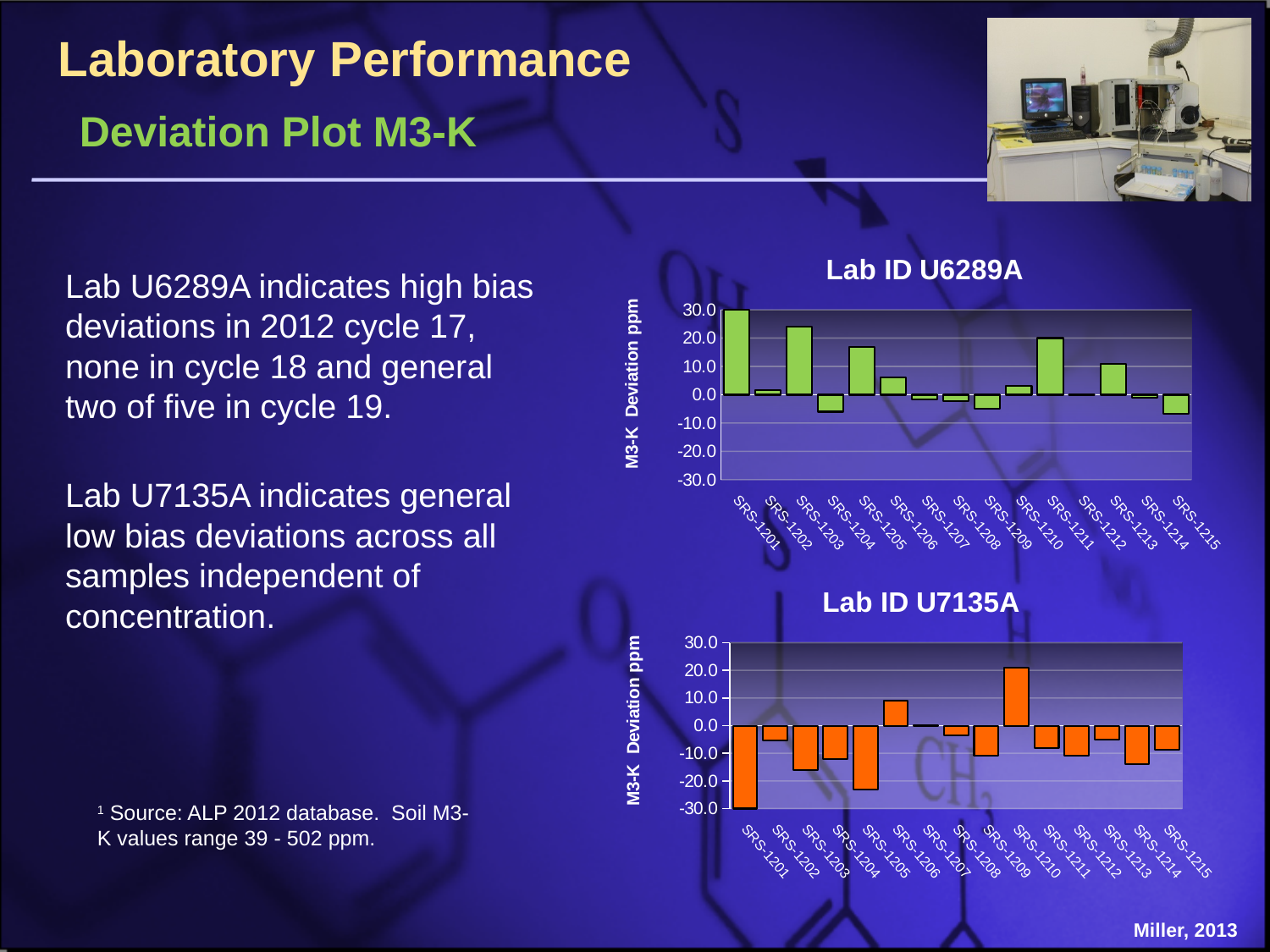
How many sample categories are plotted on the Lab ID U7135A chart? 15 On the Lab ID U7135A chart, which sample has the lowest deviation? SRS-1201 On the Lab ID U7135A chart, is the value for SRS-1205 greater or less than -20.0? less What is the y-axis label on the Lab ID U7135A chart? M3-K Deviation ppm What kind of chart is the Lab ID U6289A chart? bar chart On the Lab ID U6289A chart, which sample has the highest deviation? SRS-1201 On the Lab ID U7135A chart, which is larger, the value for SRS-1206 or the value for SRS-1203? SRS-1206 On the Lab ID U7135A chart, which sample has the highest deviation? SRS-1210 On the Lab ID U6289A chart, which is larger, the value for SRS-1205 or the value for SRS-1206? SRS-1205 What colour are the bars on the Lab ID U7135A chart? orange On the Lab ID U6289A chart, is the value for SRS-1203 greater or less than 20.0? greater